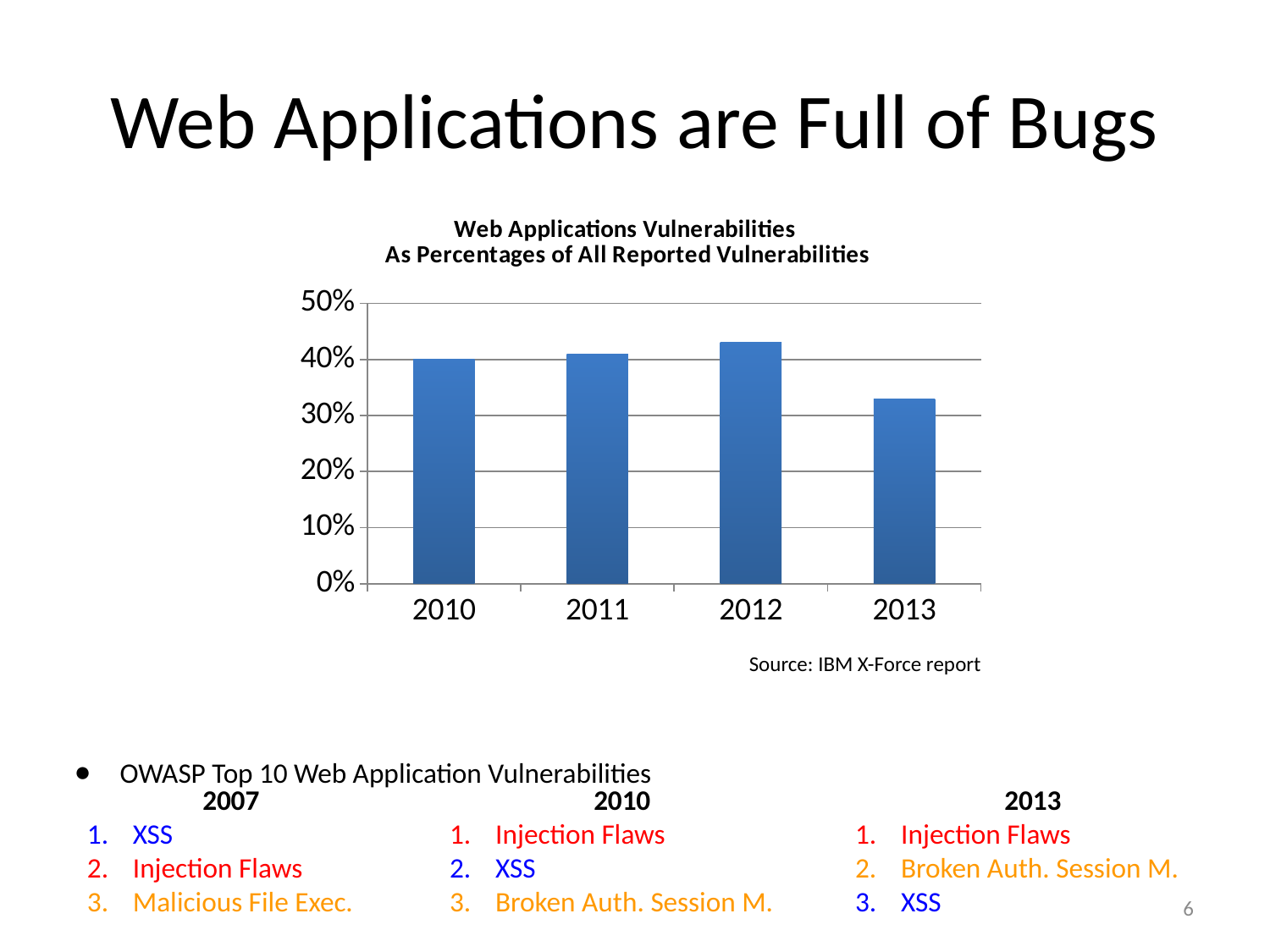
Which year has the lowest percentage of web application vulnerabilities? 2013 Which year has the larger value, 2010 or 2013? 2010 What source is cited for the chart? IBM X-Force report What kind of chart is shown on the slide? Bar chart Is the value for 2013 greater or less than 30%? greater Is the value for 2012 greater or less than 40%? greater Is the value for 2013 greater or less than 40%? less Which year has the larger value, 2012 or 2013? 2012 How many years are plotted in the chart? 4 Does the percentage rise or fall from 2012 to 2013? Fall What is the title of the chart? Web Applications Vulnerabilities As Percentages of All Reported Vulnerabilities Which year has the highest percentage of web application vulnerabilities? 2012